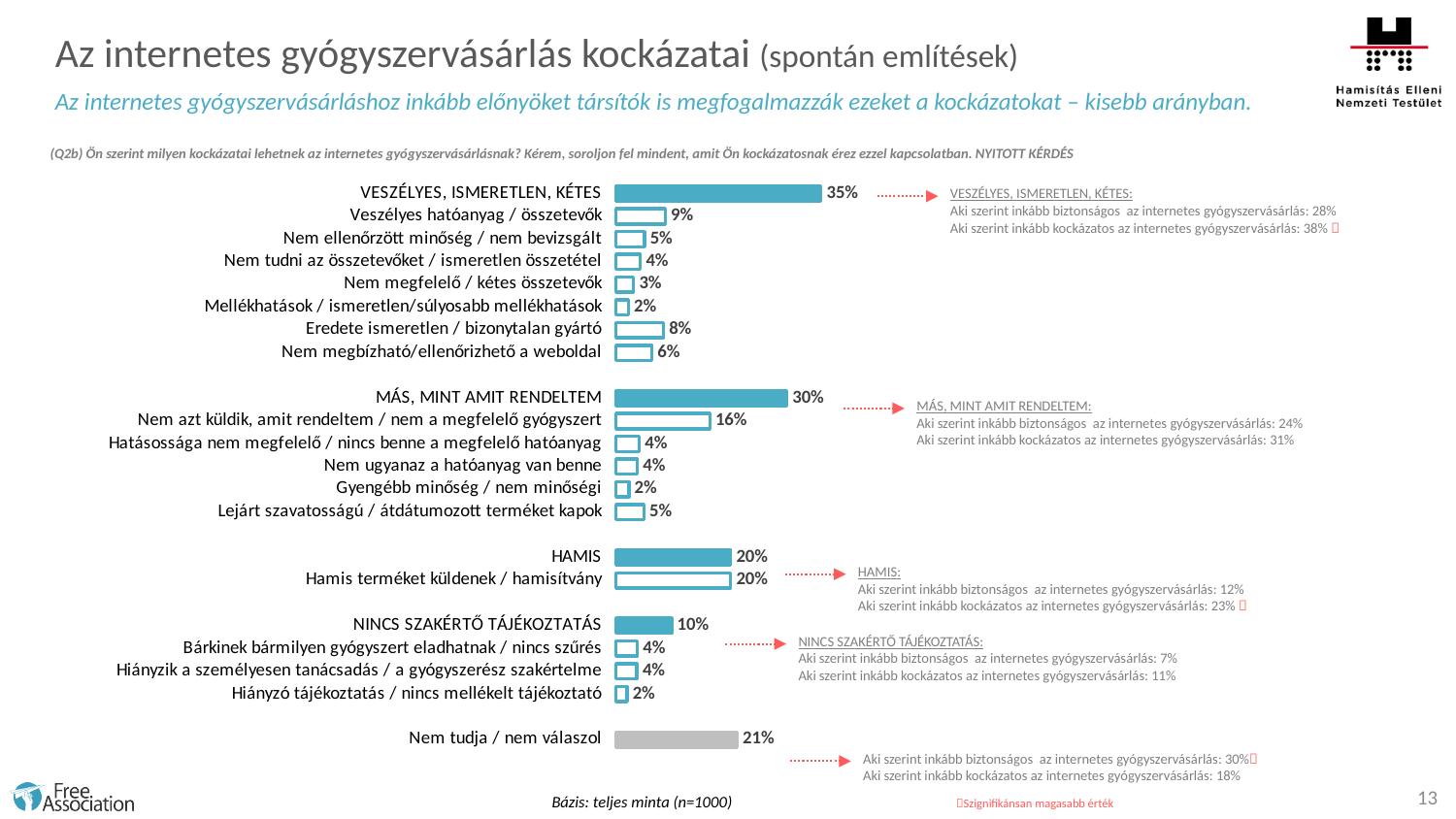
What is the sample size (base) stated below the chart? n=1000 What type of chart is shown on the slide? bar chart What is the difference between the values for "VESZÉLYES, ISMERETLEN, KÉTES" and "MÁS, MINT AMIT RENDELTEM"? 5% Which is larger: the value for "HAMIS" or the value for "Nem tudja / nem válaszol"? Nem tudja / nem válaszol What percentage is shown for "Nem azt küldik, amit rendeltem / nem a megfelelő gyógyszert"? 16% What is the difference between the values for "Veszélyes hatóanyag / összetevők" and "Eredete ismeretlen / bizonytalan gyártó"? 1% What percentage is shown for "NINCS SZAKÉRTŐ TÁJÉKOZTATÁS"? 10% Which category has the highest value in the chart? VESZÉLYES, ISMERETLEN, KÉTES What percentage is shown for "VESZÉLYES, ISMERETLEN, KÉTES"? 35% What percentage is shown for "Nem tudja / nem válaszol"? 21% What percentage is shown for "MÁS, MINT AMIT RENDELTEM"? 30% What is the lowest value shown in the chart? 2%